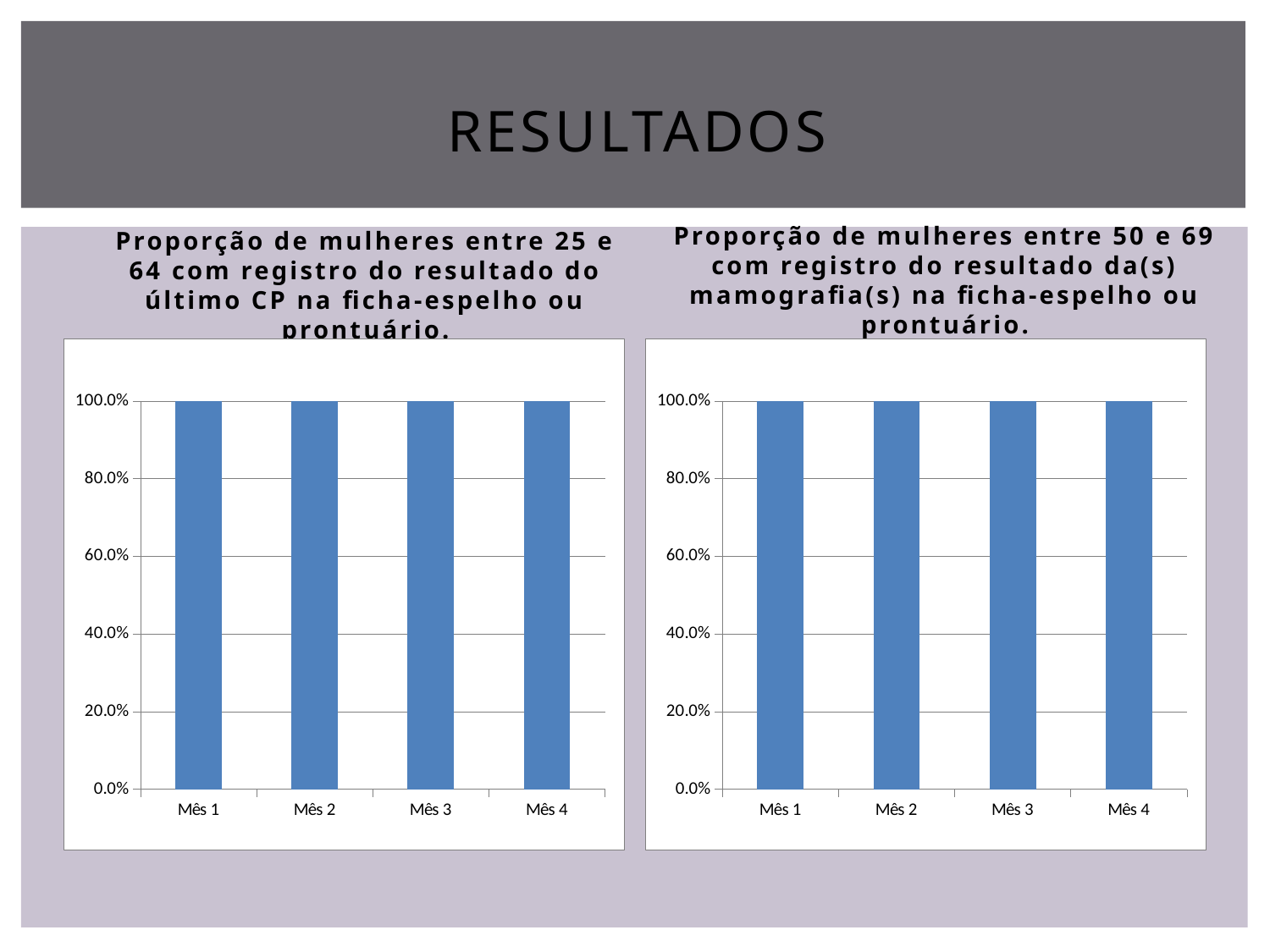
What is the title of the slide? RESULTADOS In the left chart, do the values rise, fall, or stay the same from Mês 1 to Mês 4? Stay the same In the right chart, what is the difference between the values for Mês 1 and Mês 3? 0.0% In the right chart, how many bars are plotted? 4 In the right chart (Proporção de mulheres entre 50 e 69 com registro do resultado da(s) mamografia(s)), what is the value for Mês 4? 100.0% What kind of chart is the right chart? Bar chart In the left chart, is the value for Mês 3 greater or less than 80.0%? greater What kind of chart is the left chart? Bar chart In the left chart, how many months are shown on the x axis? 4 In the right chart, do the values rise, fall, or stay the same across the months? Stay the same In the left chart (Proporção de mulheres entre 25 e 64 com registro do resultado do último CP), what is the value for Mês 1? 100.0% In the right chart, is the value for Mês 2 greater or less than 60.0%? greater